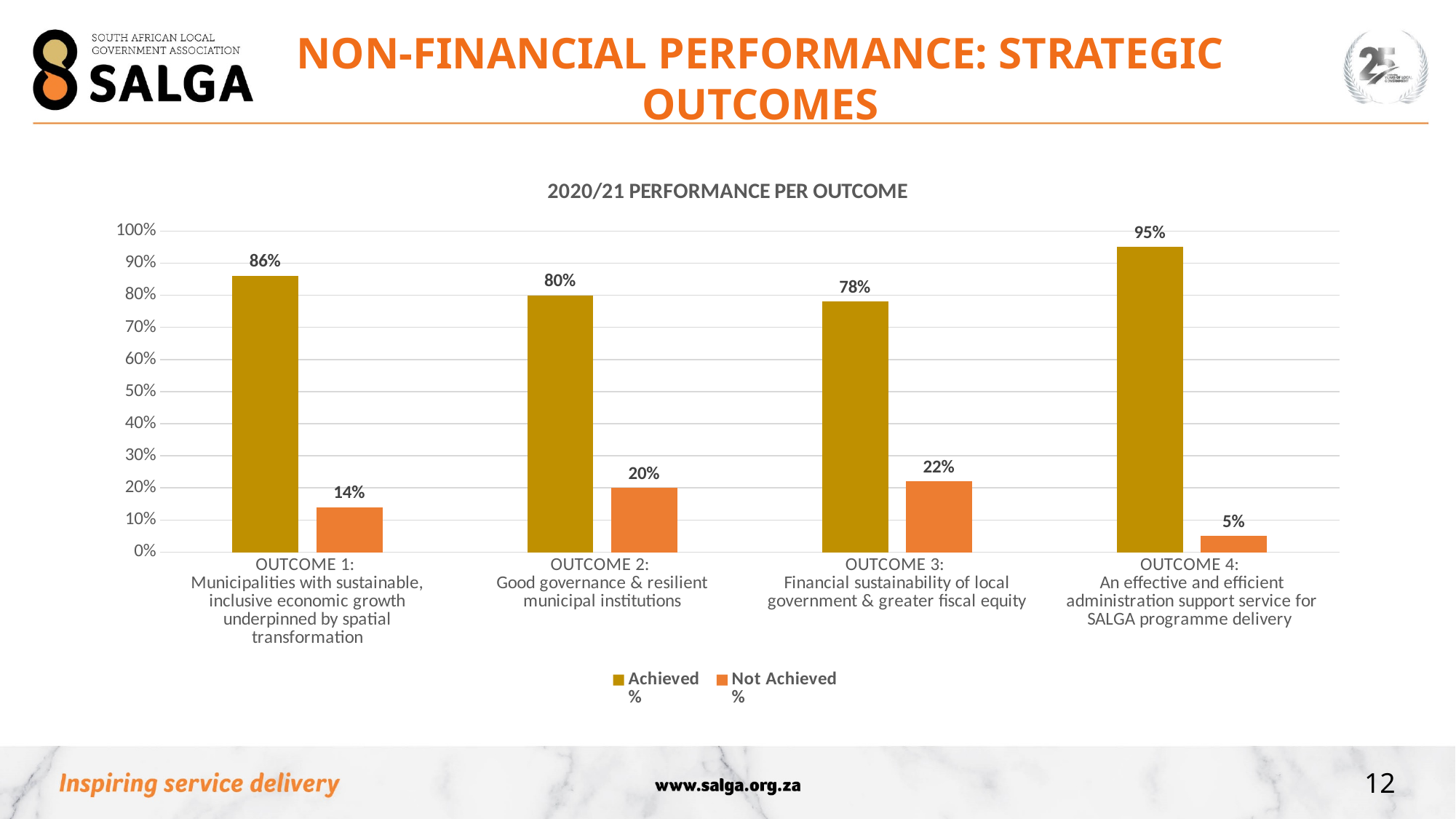
What is the Not Achieved % value for Outcome 3? 22% Is the Achieved % value for Outcome 3 greater or less than 70%? greater Which outcome has the highest Achieved % value? Outcome 4 How many outcomes are shown on the x axis of the chart? 4 What is the difference between the Achieved % values for Outcome 1 and Outcome 2? 6% What is the Achieved % value for Outcome 4? 95% How many series does the chart legend list? 2 Which is larger: the Not Achieved % for Outcome 2 or for Outcome 3? Outcome 3 What kind of chart is shown on the slide? Bar chart What is the title of the chart? 2020/21 PERFORMANCE PER OUTCOME What is the Achieved % value for Outcome 1? 86% Which outcome has the lowest Not Achieved % value? Outcome 4